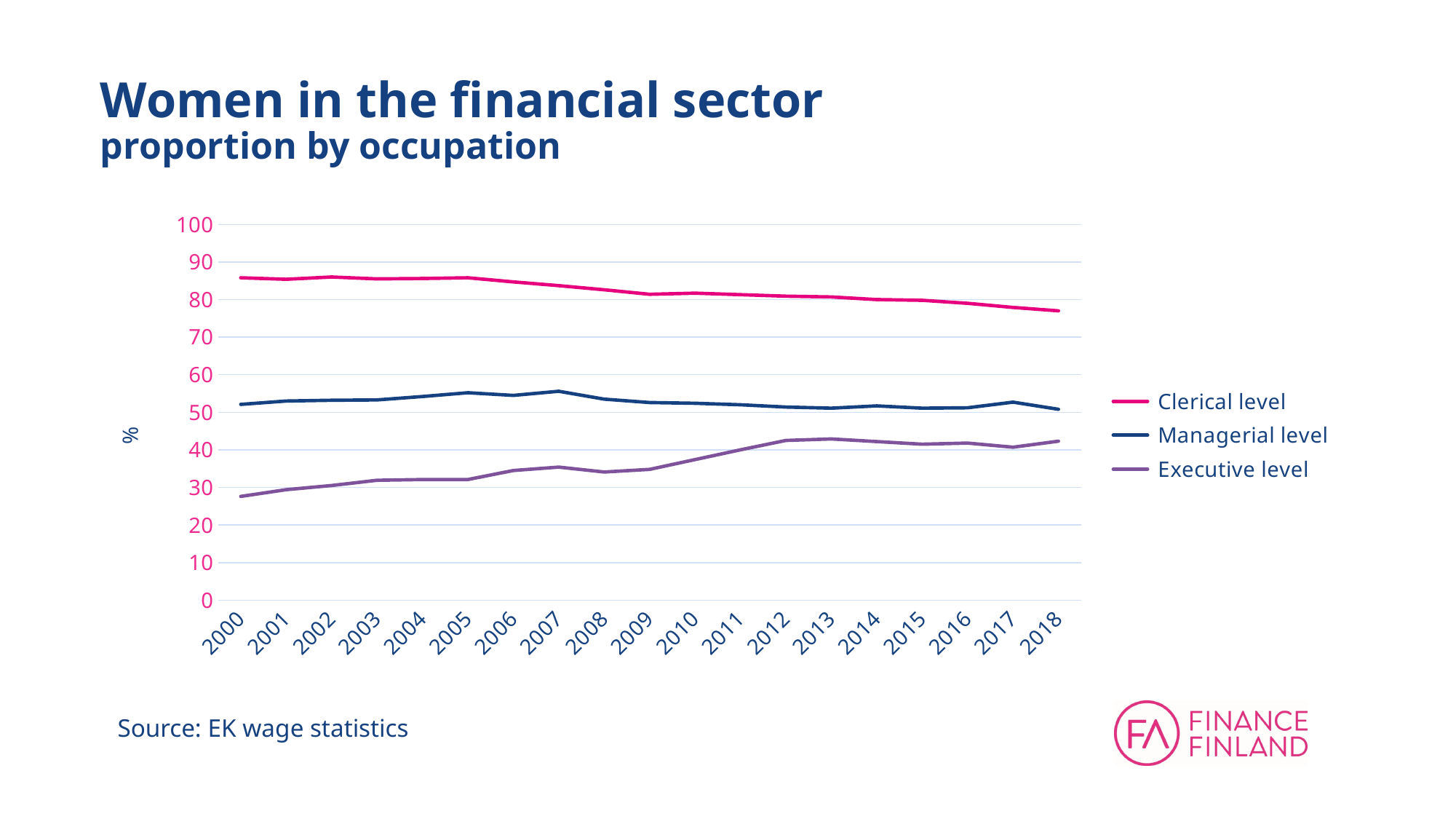
How many years are shown on the x axis? 19 Is the value for Executive level in 2000 greater or less than 30? less What is the label on the y axis? % Is the value for Clerical level in 2000 greater or less than 80? greater In 2010, which is larger: Managerial level or Executive level? Managerial level Which series has the highest values across all years? Clerical level What kind of chart is shown on the slide? line chart Is the value for Clerical level in 2018 greater or less than 80? less Does the Clerical level line rise or fall from 2000 to 2018? fall How many series does the legend list? 3 Which series has the lowest values across all years? Executive level Does the Executive level line rise or fall from 2000 to 2018? rise